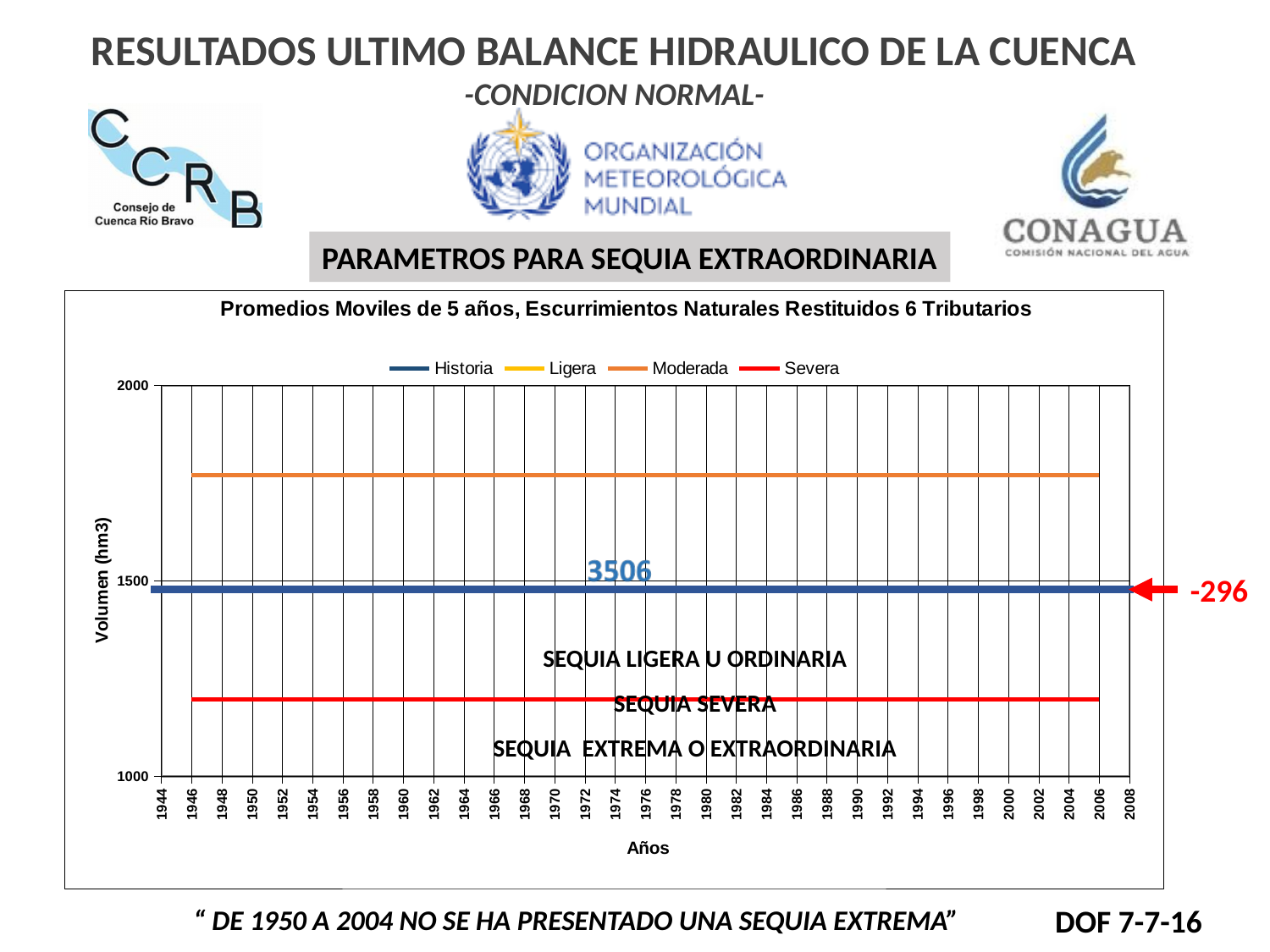
What are the series names listed in the chart legend? Historia, Ligera, Moderada, Severa Is the value of the Moderada line greater or less than 1500? greater What is the title of the chart? Promedios Moviles de 5 años, Escurrimientos Naturales Restituidos 6 Tributarios Which line is higher on the chart, Historia or Severa? Historia What kind of chart is shown on the slide? line chart Is the value of the Severa line greater or less than 1500? less Do the plotted lines rise, fall, or stay flat across the years on the x axis? stay flat How many series does the chart legend list? 4 Is the value of the Moderada line greater or less than 2000? less What is the first year and the last year labelled on the x axis? 1944 and 2008 Which line is higher on the chart, Moderada or Severa? Moderada